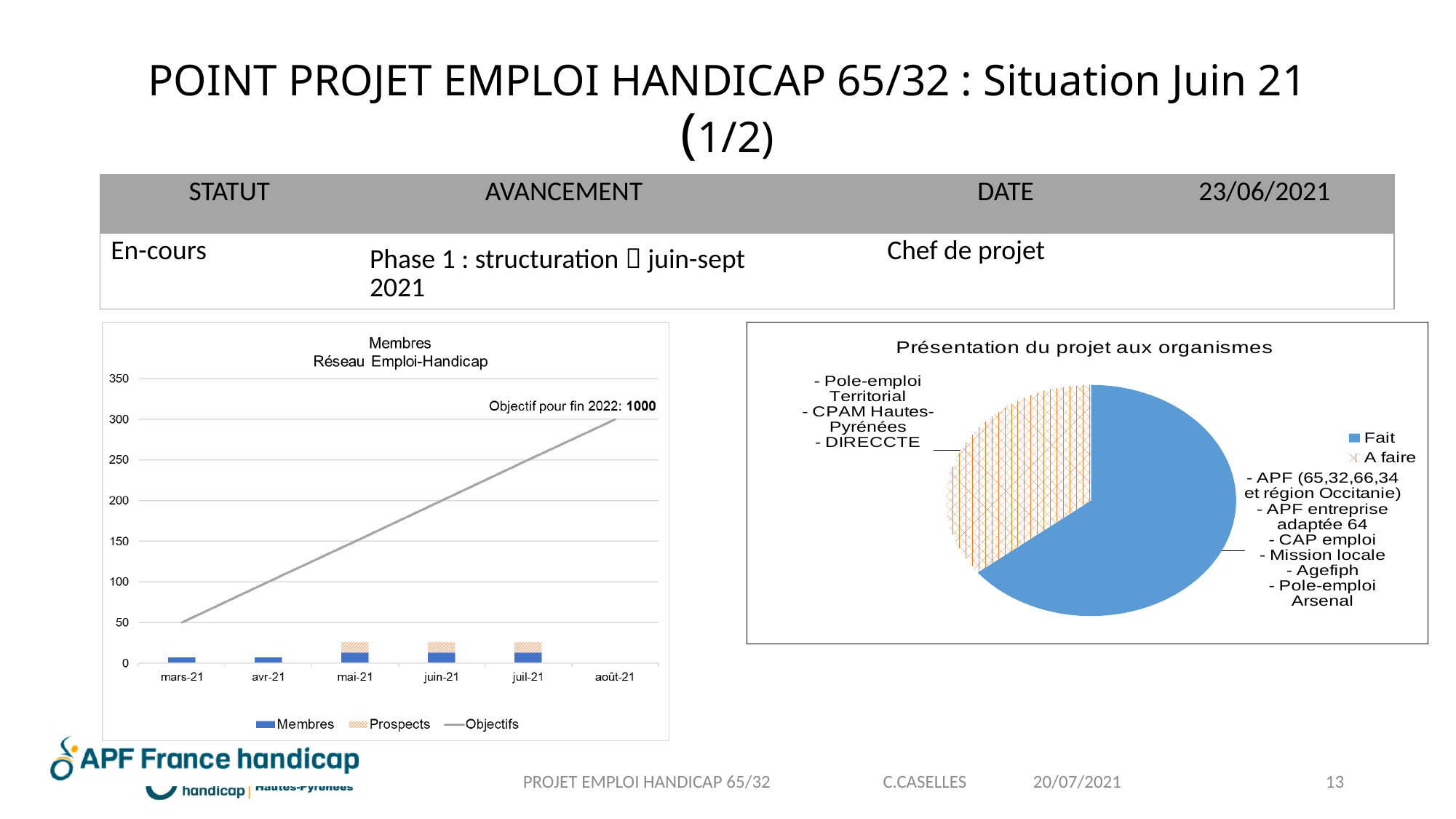
In the 'Membres Réseau Emploi-Handicap' chart, what is the difference between the Objectifs value at août-21 and at mars-21? 250 In the 'Présentation du projet aux organismes' chart, which slice is larger, Fait or A faire? Fait In the 'Membres Réseau Emploi-Handicap' chart, does the Objectifs line rise or fall from mars-21 to août-21? rise What kind of chart is 'Présentation du projet aux organismes'? pie chart In the 'Membres Réseau Emploi-Handicap' chart, how many series does the legend list? 3 In the 'Membres Réseau Emploi-Handicap' chart, what is the value of the Objectifs line at août-21? 300 In the 'Présentation du projet aux organismes' chart, what are the two legend entries? Fait, A faire In the 'Présentation du projet aux organismes' chart, how many slices does the pie have? 2 In the 'Membres Réseau Emploi-Handicap' chart, what is the stated objective for the end of 2022? 1000 In the 'Membres Réseau Emploi-Handicap' chart, how many months are shown on the x axis? 6 In the 'Membres Réseau Emploi-Handicap' chart, is the Membres value for juin-21 greater or less than 50? less In the 'Membres Réseau Emploi-Handicap' chart, what is the value of the Objectifs line at mars-21? 50